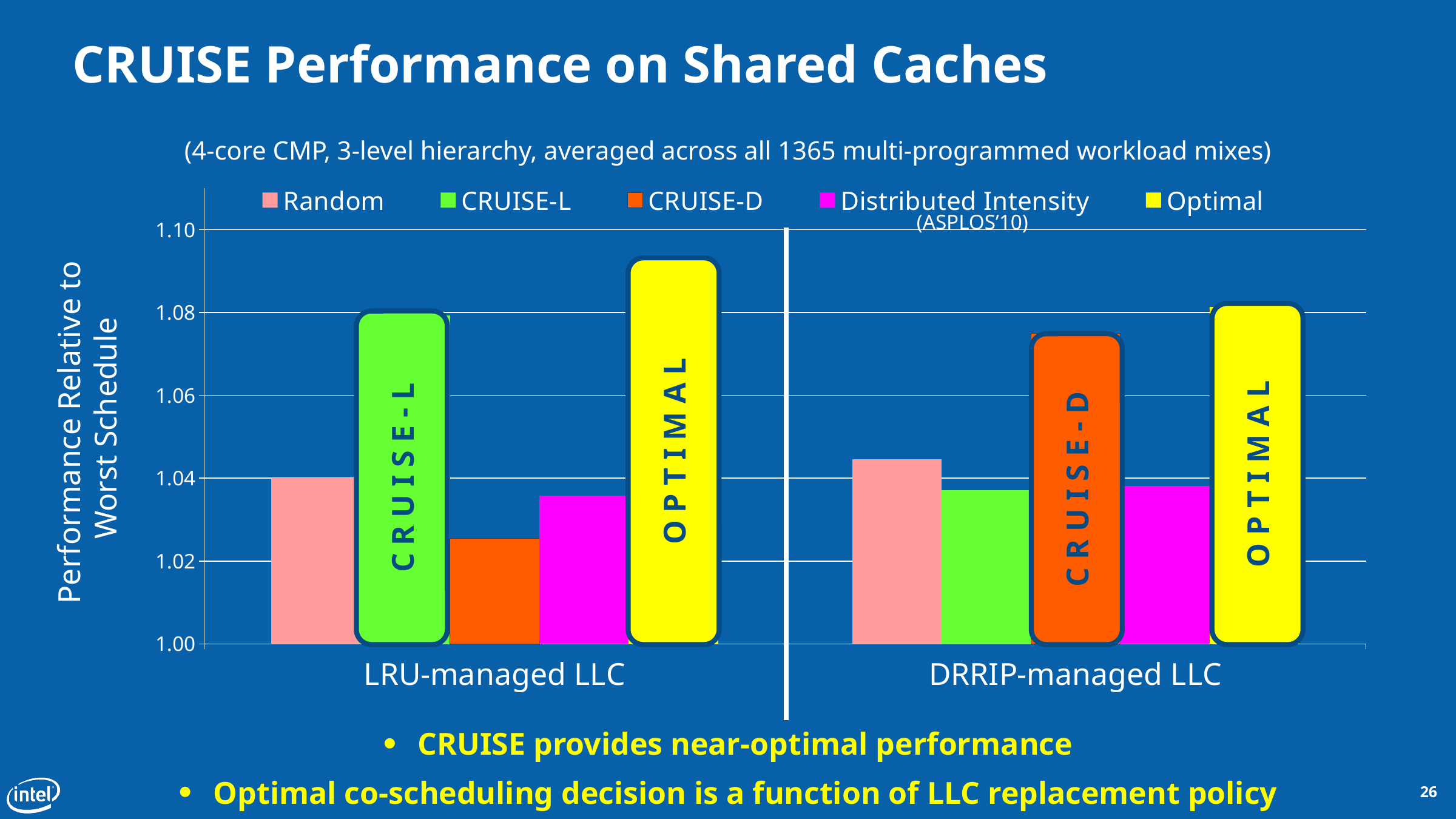
For DRRIP-managed LLC, which is larger: CRUISE-D or Random? CRUISE-D Which series has the lowest value for LRU-managed LLC? CRUISE-D How many LLC management categories are shown on the x axis? 2 Which series has the highest value for DRRIP-managed LLC? Optimal How many series does the legend list? 5 Is the value for CRUISE-D under LRU-managed LLC greater or less than 1.04? less What is the title of the y axis? Performance Relative to Worst Schedule Which series has the highest value for LRU-managed LLC? Optimal For LRU-managed LLC, which is larger: CRUISE-L or CRUISE-D? CRUISE-L Is the value for CRUISE-D under DRRIP-managed LLC greater or less than 1.06? greater What kind of chart is shown on the slide? bar chart Is the value for Optimal under LRU-managed LLC greater or less than 1.08? greater